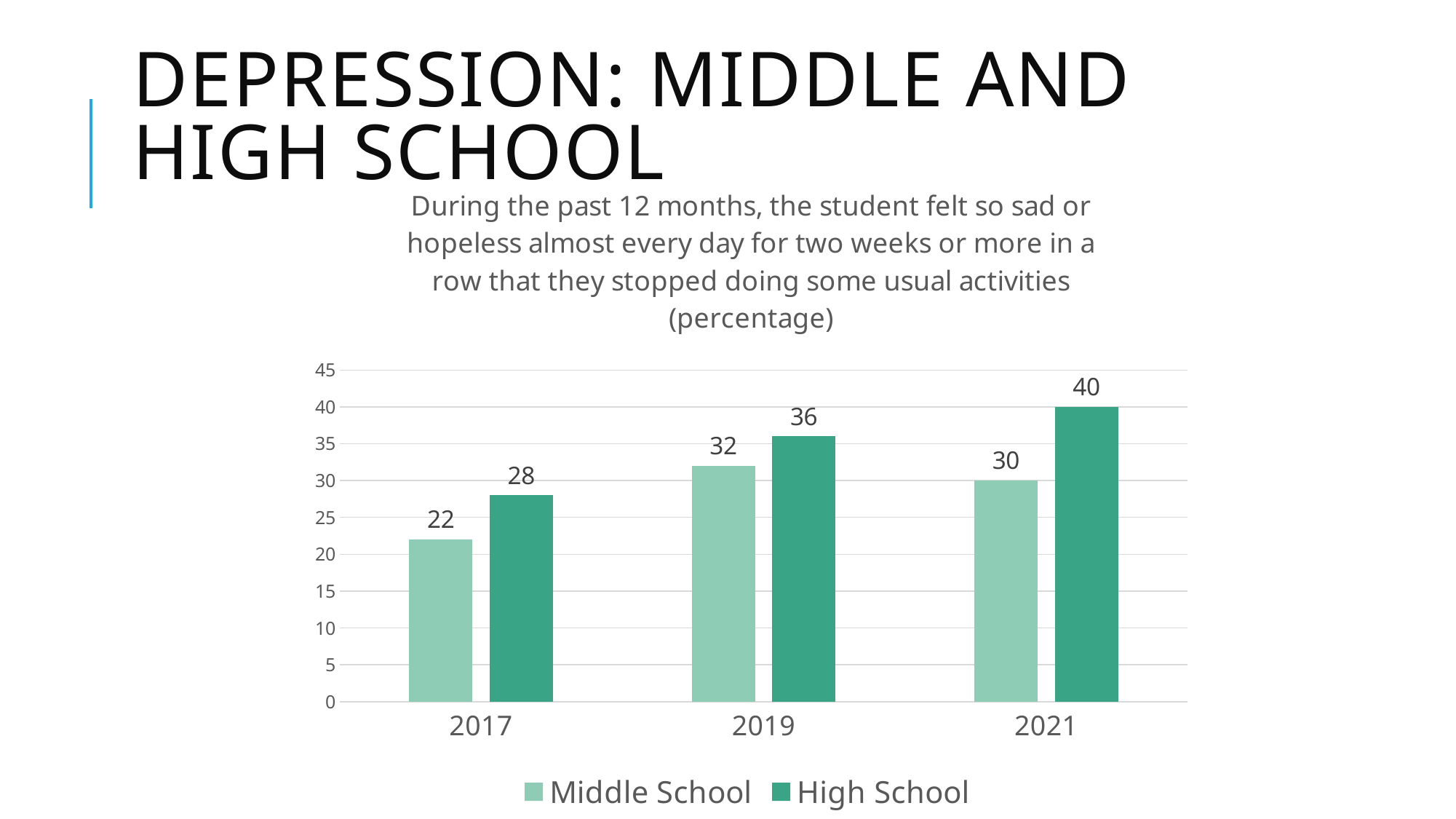
In which year is the Middle School value highest? 2019 In which year is the High School value lowest? 2017 What kind of chart is shown on the slide? Bar chart What is the High School value for 2021? 40 By how much did the High School value increase from 2017 to 2021? 12 How many series does the legend list? 2 What is the Middle School value for 2017? 22 Does the High School value rise or fall from 2017 to 2021? Rise What is the difference between the High School and Middle School values in 2021? 10 How many years are shown on the x axis? 3 Which is larger, the Middle School value in 2019 or the Middle School value in 2021? 2019 What is the High School value for 2019? 36